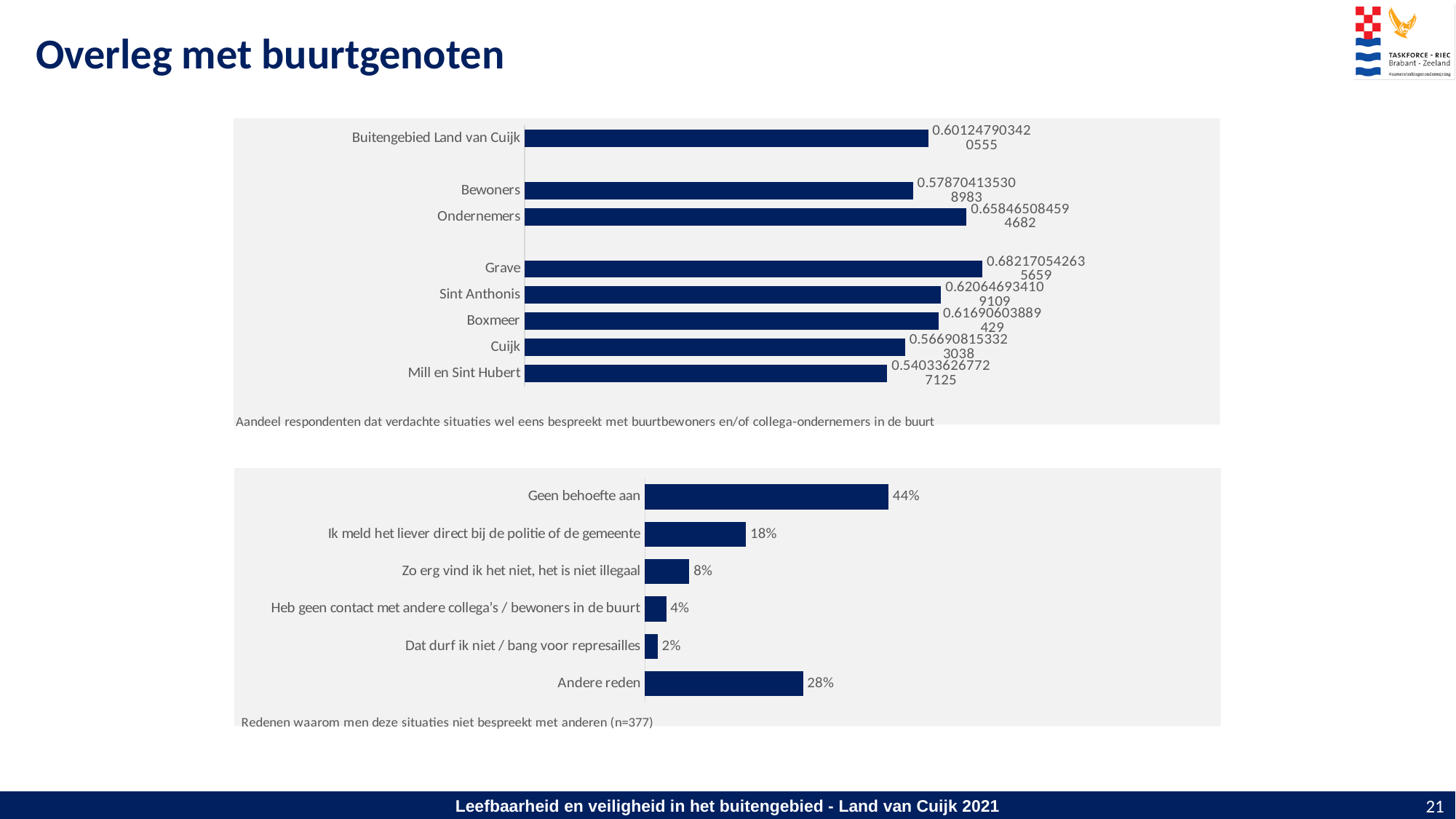
What type of chart is the top chart on the slide? Bar chart In the bottom chart, which reason has the highest value? Geen behoefte aan In the bottom chart, which reason has the lowest value? Dat durf ik niet / bang voor represailles In the bottom chart, what is the value for 'Andere reden'? 28% How many reasons are shown in the bottom chart? 6 In the top chart (Aandeel respondenten dat verdachte situaties wel eens bespreekt met buurtbewoners), which category has the highest value? Grave In the bottom chart, which is larger: 'Zo erg vind ik het niet, het is niet illegaal' or 'Heb geen contact met andere collega's / bewoners in de buurt'? Zo erg vind ik het niet, het is niet illegaal In the bottom chart, what is the value for 'Ik meld het liever direct bij de politie of de gemeente'? 18% In the bottom chart (Redenen waarom men deze situaties niet bespreekt met anderen), what is the value for 'Geen behoefte aan'? 44% In the bottom chart, what is the difference between 'Geen behoefte aan' and 'Andere reden'? 16% In the top chart, which category has the lowest value? Mill en Sint Hubert In the top chart, which is larger: Ondernemers or Bewoners? Ondernemers